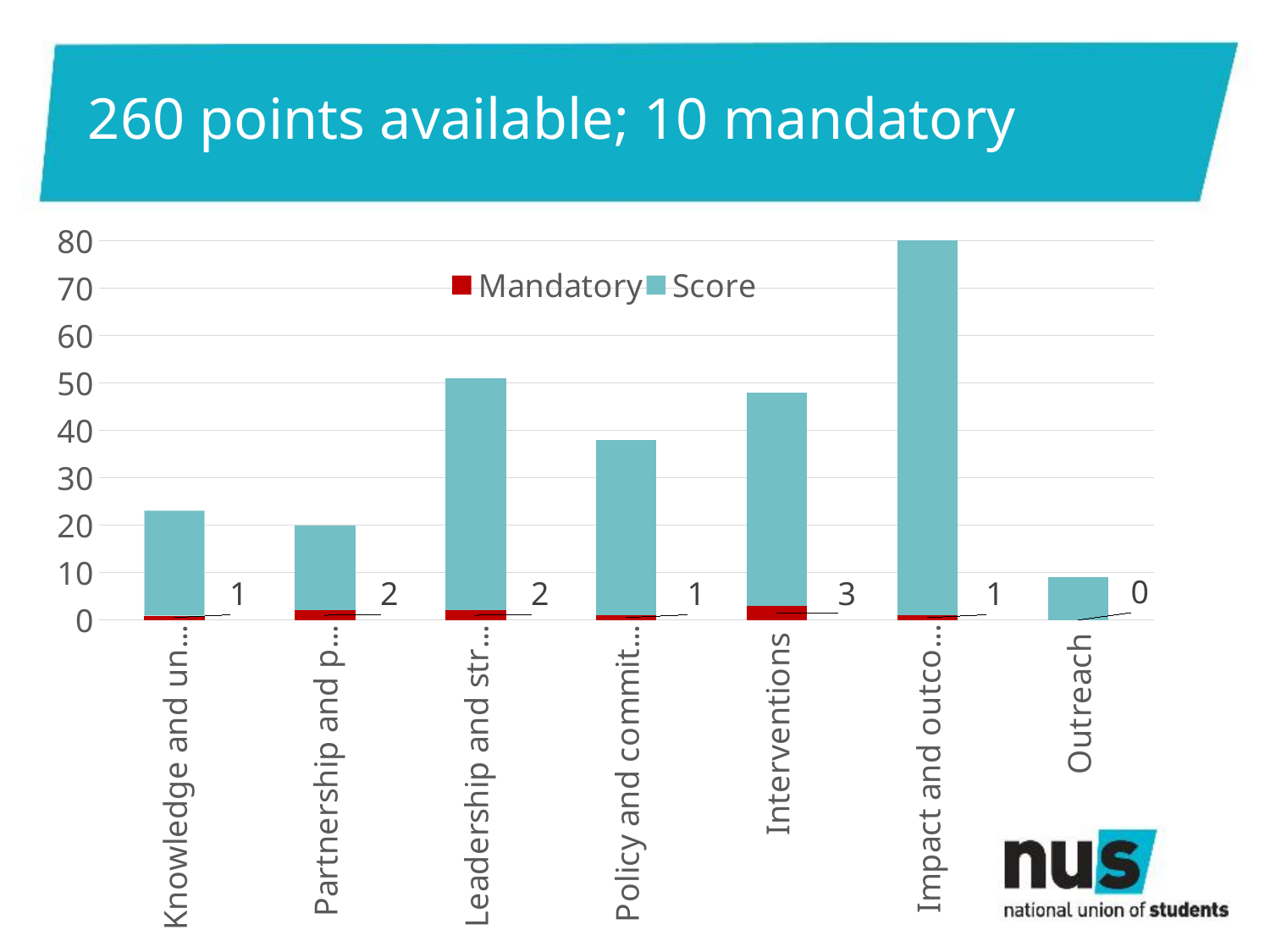
How many categories are shown on the x axis? 7 What is the title of the slide? 260 points available; 10 mandatory What kind of chart is shown on the slide? Bar chart Which category has the lowest Mandatory value? Outreach Which category has the taller stacked bar overall, Interventions or Outreach? Interventions What is the Mandatory value for Interventions? 3 How many series does the legend list? 2 What is the difference between the Mandatory values for Interventions and Outreach? 3 What is the Mandatory value for Outreach? 0 Is the Score value for Interventions greater or less than 40? greater Which category has the highest Mandatory value? Interventions